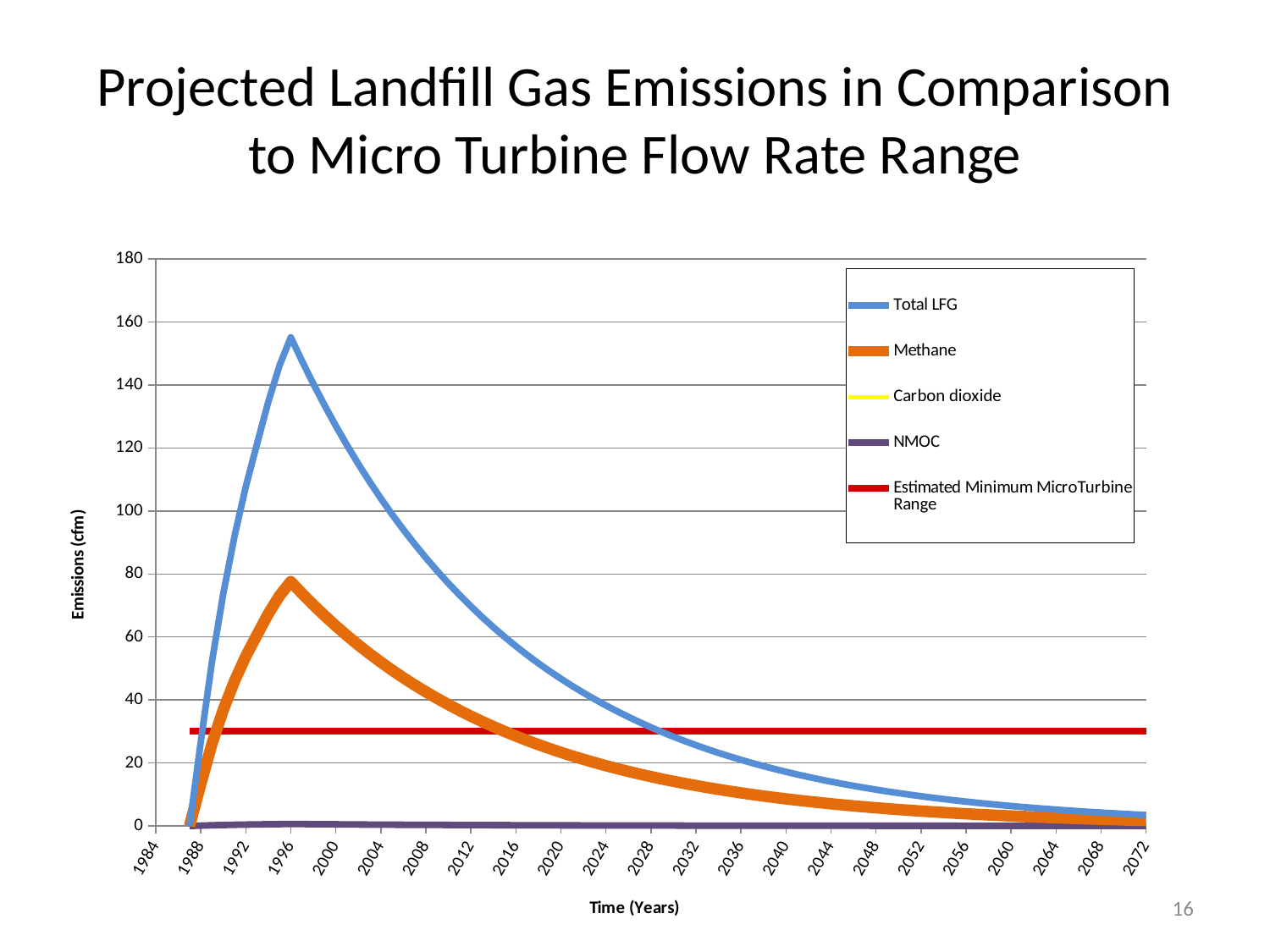
Does the Total LFG series rise or fall between 1996 and 2072? Fall In which year does the Total LFG series reach its peak? 1996 What is the title of the chart? Projected Landfill Gas Emissions in Comparison to Micro Turbine Flow Rate Range Which is larger in 2008, Total LFG or Methane? Total LFG Is the peak value of Total LFG in 1996 greater or less than 140? greater How many series does the legend list? 5 Is the Estimated Minimum MicroTurbine Range line greater or less than 20? greater What kind of chart is shown on the slide? Line chart Which series reaches the highest value on the chart? Total LFG Is the Estimated Minimum MicroTurbine Range line greater or less than 40? less What is the label of the vertical axis? Emissions (cfm)